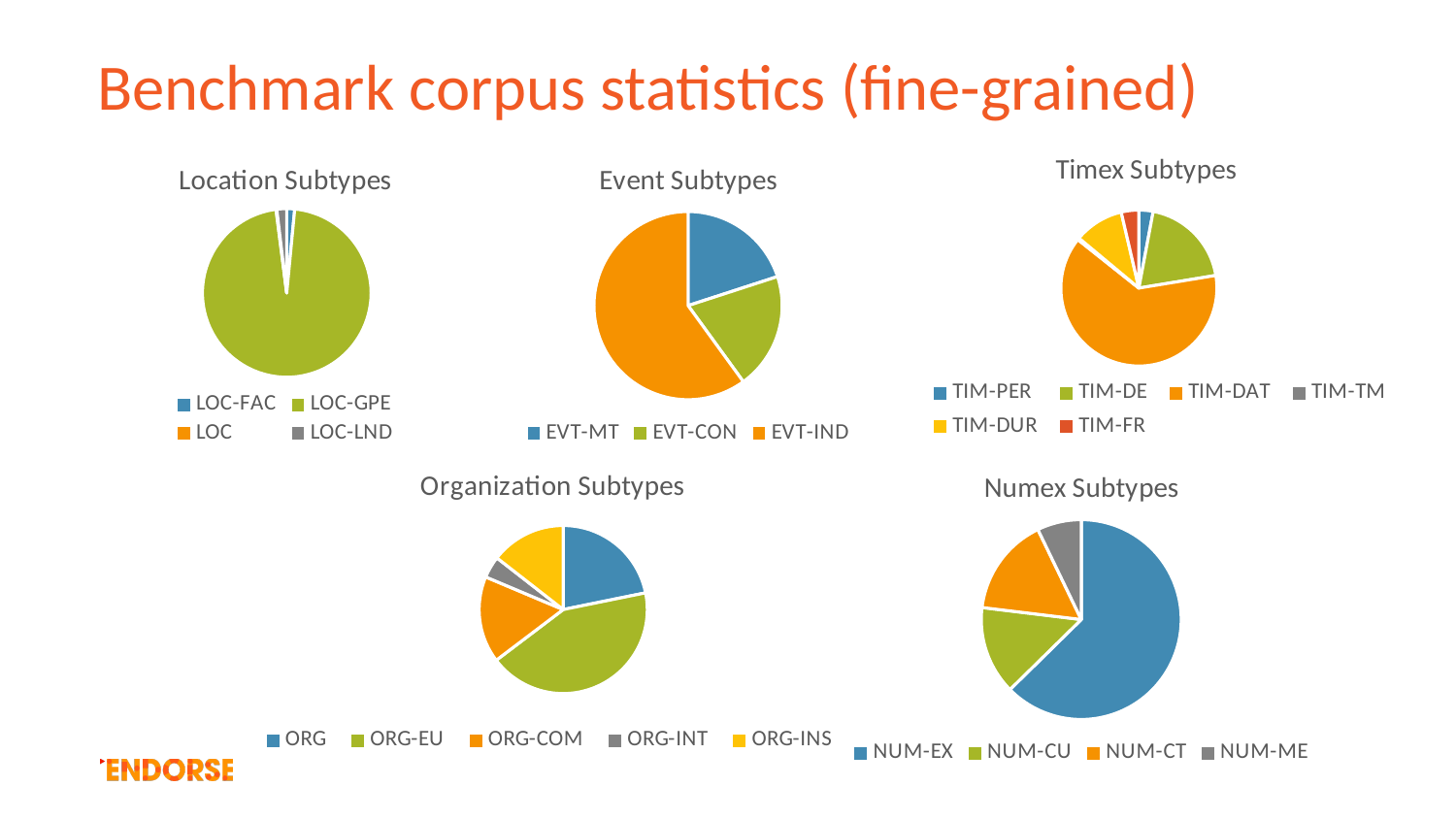
How many categories does the legend of the Timex Subtypes chart list? 6 In the Numex Subtypes chart, which subtype has the smallest slice? NUM-ME In the Event Subtypes chart, which subtype has the largest slice? EVT-IND In the Location Subtypes chart, which subtype has the largest slice? LOC-GPE In the Timex Subtypes chart, which subtype has the largest slice? TIM-DAT How many categories does the legend of the Event Subtypes chart list? 3 How many pie charts are shown on the slide? 5 How many categories does the legend of the Location Subtypes chart list? 4 In the Organization Subtypes chart, which subtype has the smallest slice? ORG-INT What kind of chart is used for the Location Subtypes chart? pie chart In the Timex Subtypes chart, which slice is larger, TIM-DE or TIM-PER? TIM-DE